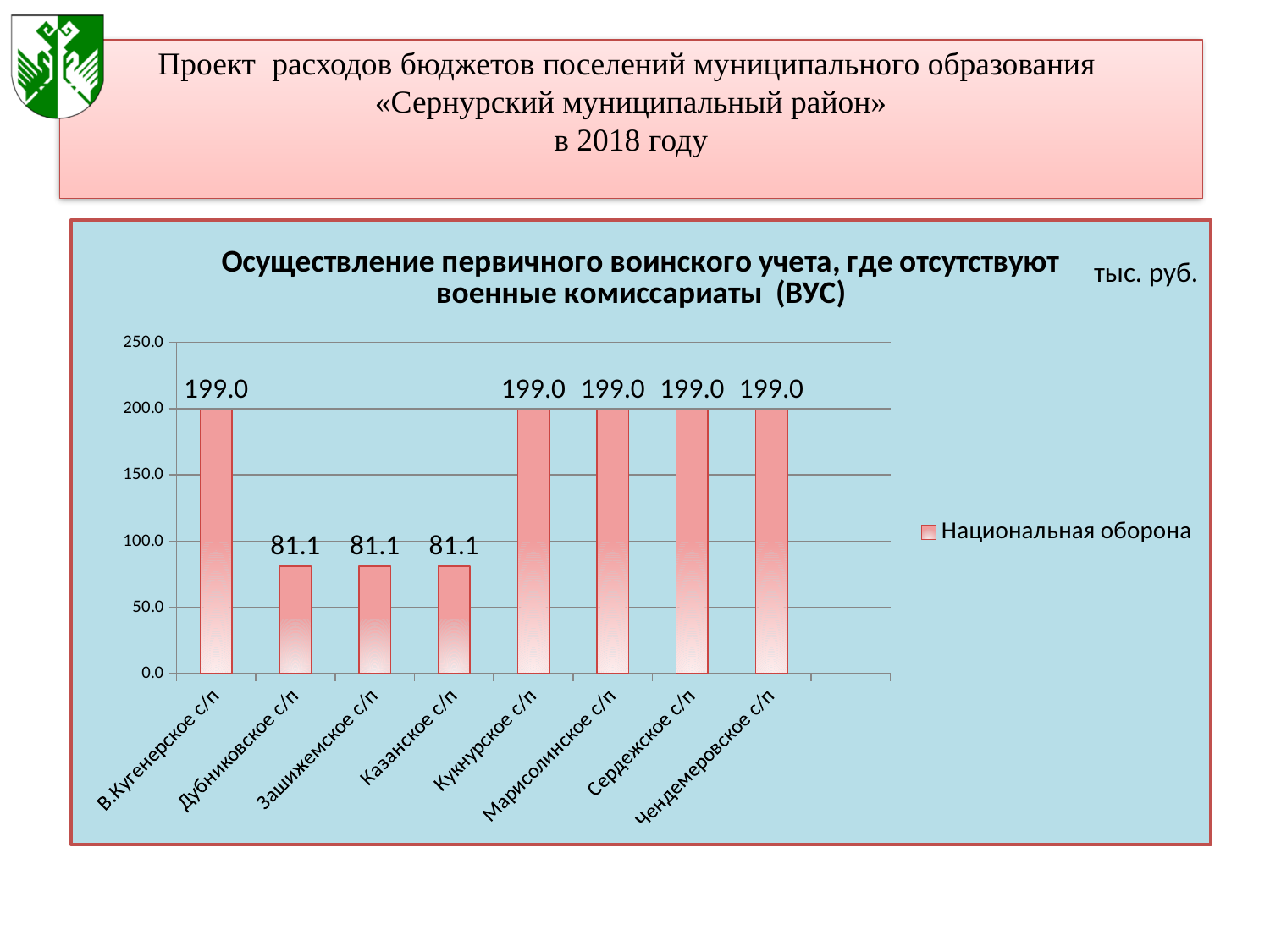
What kind of chart is shown? bar chart What is the name of the series in the legend? Национальная оборона Is the value for Казанское с/п greater or less than 100.0? less What is the value for Дубниковское с/п? 81.1 What is the value for Сердежское с/п? 199.0 Which is larger, the value for Марисолинское с/п or the value for Зашижемское с/п? Марисолинское с/п How many series does the legend list? 1 What unit is indicated next to the chart title? тыс. руб. What is the difference between the values for Кукнурское с/п and Казанское с/п? 117.9 What is the value for В.Кугенерское с/п? 199.0 How many categories are shown on the x axis? 8 Is the value for Чендемеровское с/п greater or less than 150.0? greater